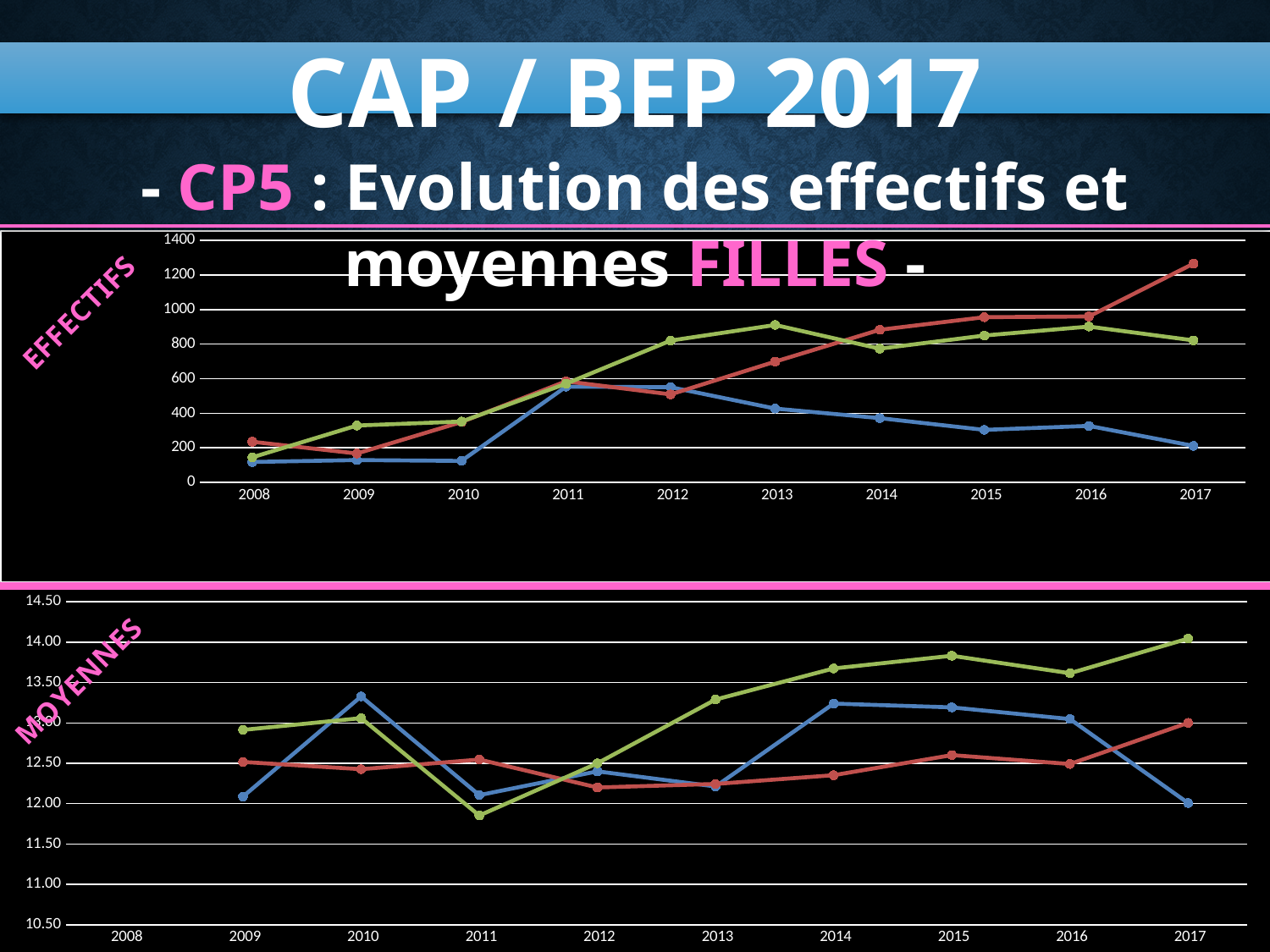
In the bottom chart (MOYENNES), is the value of the green line in 2017 greater or less than 13.50? greater In the bottom chart (MOYENNES), in which year does the green line reach its lowest value? 2011 What kind of chart is the bottom chart labelled MOYENNES? line chart What kind of chart is the top chart labelled EFFECTIFS? line chart In the bottom chart (MOYENNES), is the value of the blue line in 2017 greater or less than 12.50? less In the top chart (EFFECTIFS), is the value of the red line in 2017 greater or less than 1200? greater What label is written along the left side of the top chart? EFFECTIFS In the top chart (EFFECTIFS), which line has the larger value in 2017, the red line or the green line? red line In the top chart (EFFECTIFS), does the blue line rise or fall from 2011 to 2017? fall In the top chart (EFFECTIFS), in which year does the red line reach its highest value? 2017 In the top chart (EFFECTIFS), how many years are shown on the x axis? 10